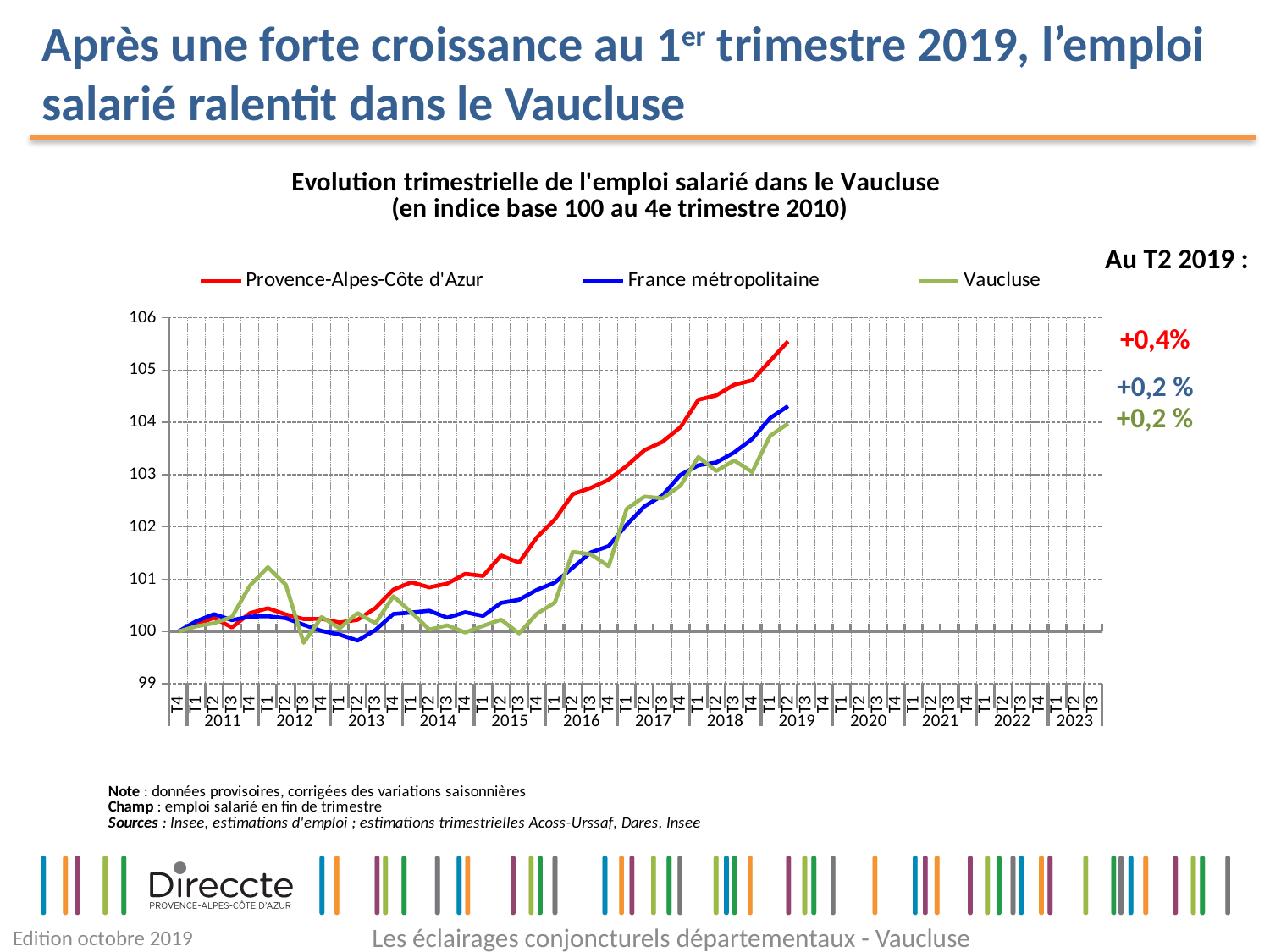
What kind of chart is shown on the slide? line chart Is the value for Provence-Alpes-Côte d'Azur at T2 2019 greater or less than 105? greater Does the Provence-Alpes-Côte d'Azur line rise or fall between 2015 and T2 2019? rise Is the value for Vaucluse at T1 2012 greater or less than 101? greater How many series does the legend list? 3 What quarterly growth rate is annotated for Provence-Alpes-Côte d'Azur at T2 2019? +0,4% Is the value for Vaucluse at T3 2012 greater or less than 100? less At T1 2012, which is larger: the value for Vaucluse or the value for Provence-Alpes-Côte d'Azur? Vaucluse Which series has the highest value at T2 2019? Provence-Alpes-Côte d'Azur Which series does the red line represent? Provence-Alpes-Côte d'Azur What is the index value of all three series at T4 2010, the base quarter? 100